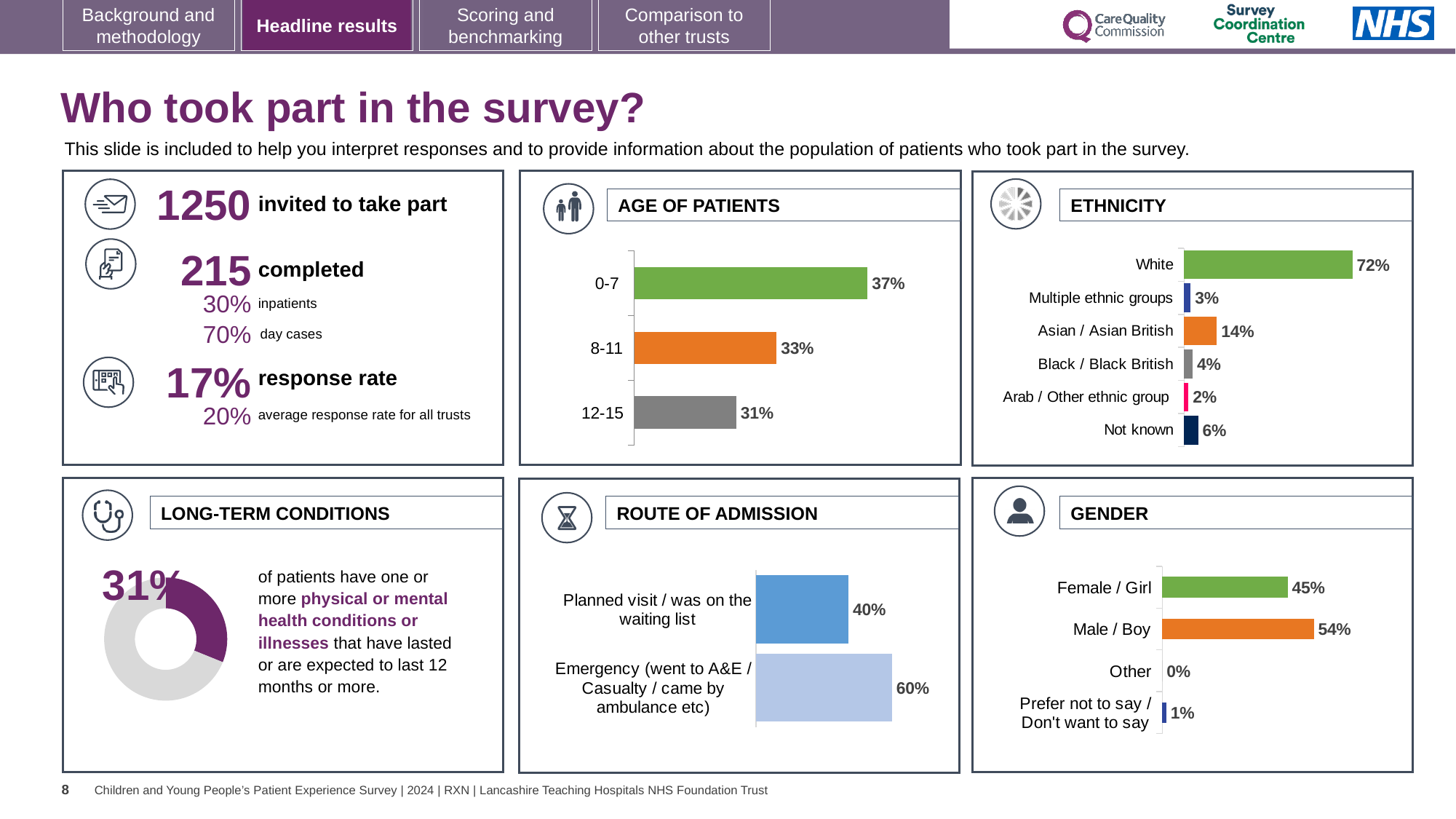
In the AGE OF PATIENTS chart, what percentage of patients were aged 0-7? 37% What kind of chart is used in the LONG-TERM CONDITIONS panel? Doughnut chart In the ROUTE OF ADMISSION chart, what is the difference between the Emergency and Planned visit percentages? 20% In the AGE OF PATIENTS chart, what is the difference between the 0-7 and 8-11 percentages? 4% In the ETHNICITY chart, which is larger: Black / Black British or Not known? Not known In the ETHNICITY chart, which category has the highest percentage? White In the ROUTE OF ADMISSION chart, what percentage of patients came via Emergency (went to A&E / Casualty / came by ambulance etc)? 60% How many categories are shown in the ETHNICITY chart? 6 In the GENDER chart, what is the difference between Male / Boy and Female / Girl? 9% In the AGE OF PATIENTS chart, which age group has the lowest percentage? 12-15 In the ETHNICITY chart, what percentage of patients were Asian / Asian British? 14% In the GENDER chart, what percentage of patients were Male / Boy? 54%